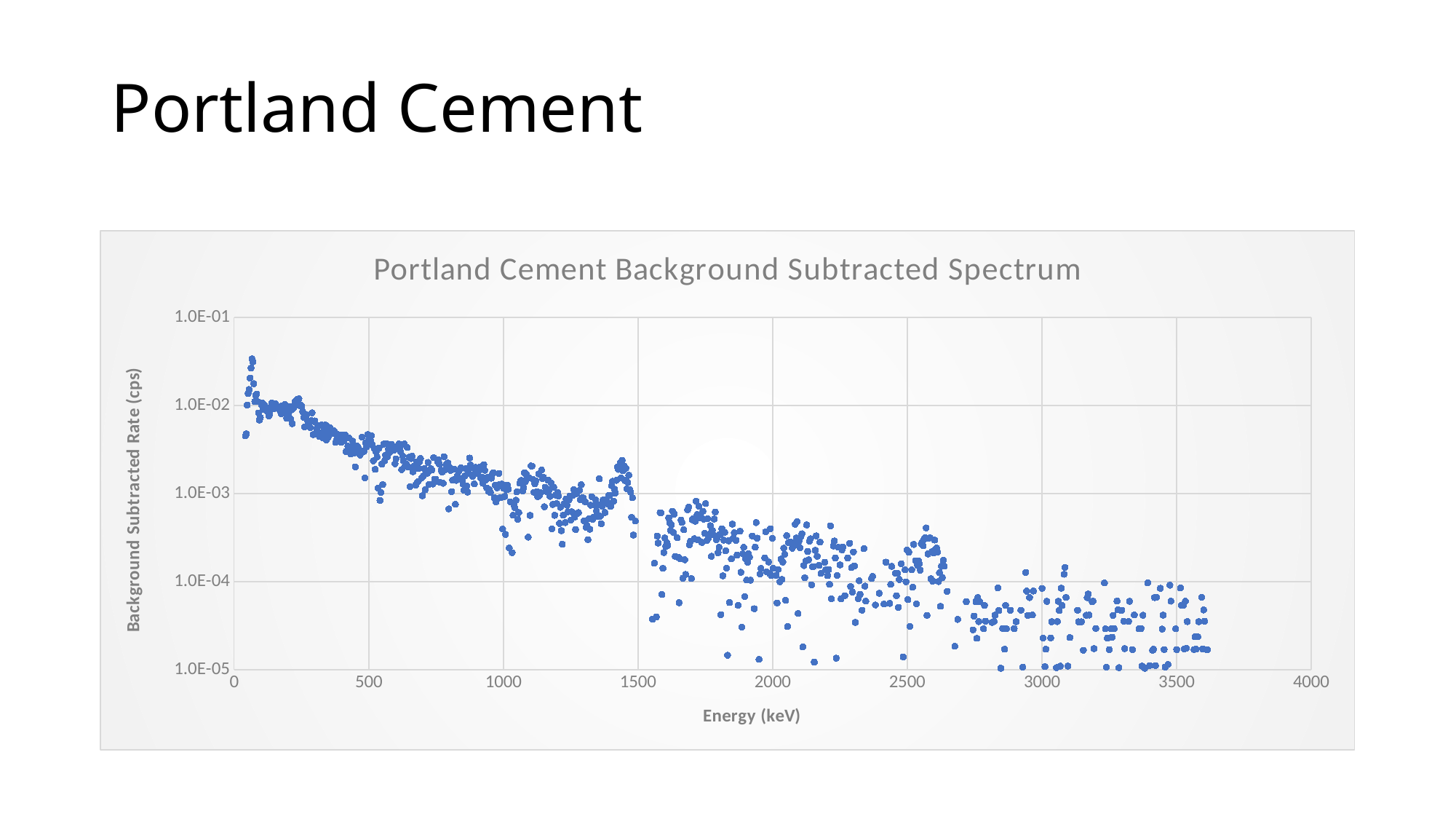
Are the values plotted near 100 keV greater or less than 1.0E-03 cps? greater In which energy region are the plotted values highest: near 0-100 keV or near 3000-3500 keV? Near 0-100 keV What kind of chart is shown on the slide? Scatter plot What is the label of the x axis? Energy (keV) What is the lowest tick value shown on the y axis? 1.0E-05 What is the title of the chart? Portland Cement Background Subtracted Spectrum Are the values plotted near 3500 keV greater or less than 1.0E-03 cps? less Are the values plotted near 300 keV greater or less than 1.0E-04 cps? greater Do the plotted values generally rise or fall as energy increases along the x axis? Fall